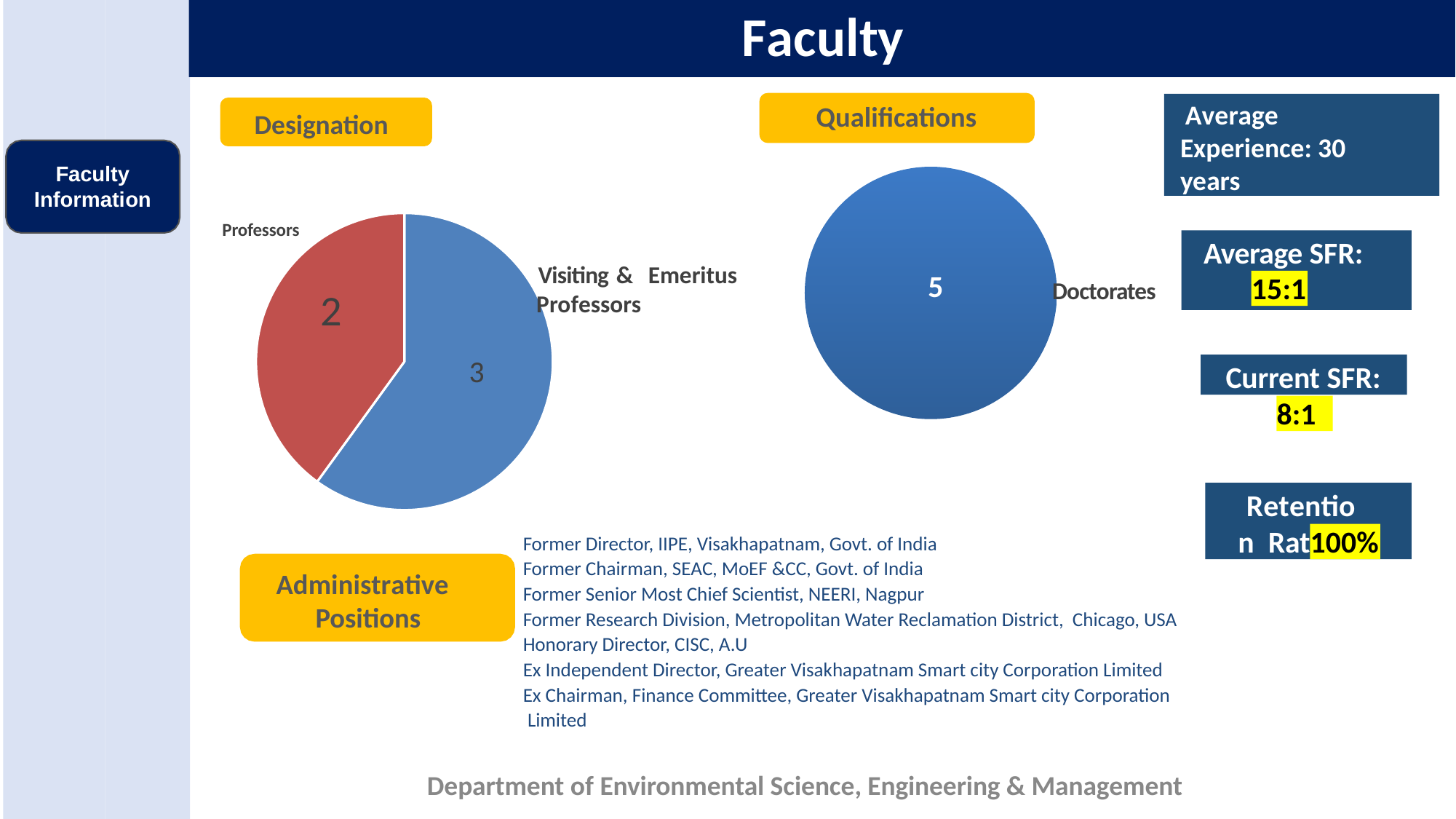
In the Designation chart, what colour is the Professors slice? Red How many categories does the Qualifications chart show? 1 In the Designation chart, what is the difference between the Visiting & Emeritus Professors value and the Professors value? 1 What kind of chart is the Designation chart? Pie chart In the Designation chart, what is the value for Visiting & Emeritus Professors? 3 In the Qualifications chart, what is the value for Doctorates? 5 In the Designation chart, what is the value for Professors? 2 In the Designation chart, which category has the smallest slice? Professors How many categories does the Designation chart show? 2 In the Designation chart, which category has the largest slice? Visiting & Emeritus Professors In the Designation chart, which is larger: Professors or Visiting & Emeritus Professors? Visiting & Emeritus Professors In the Designation chart, what share of the pie do Professors represent? 40%